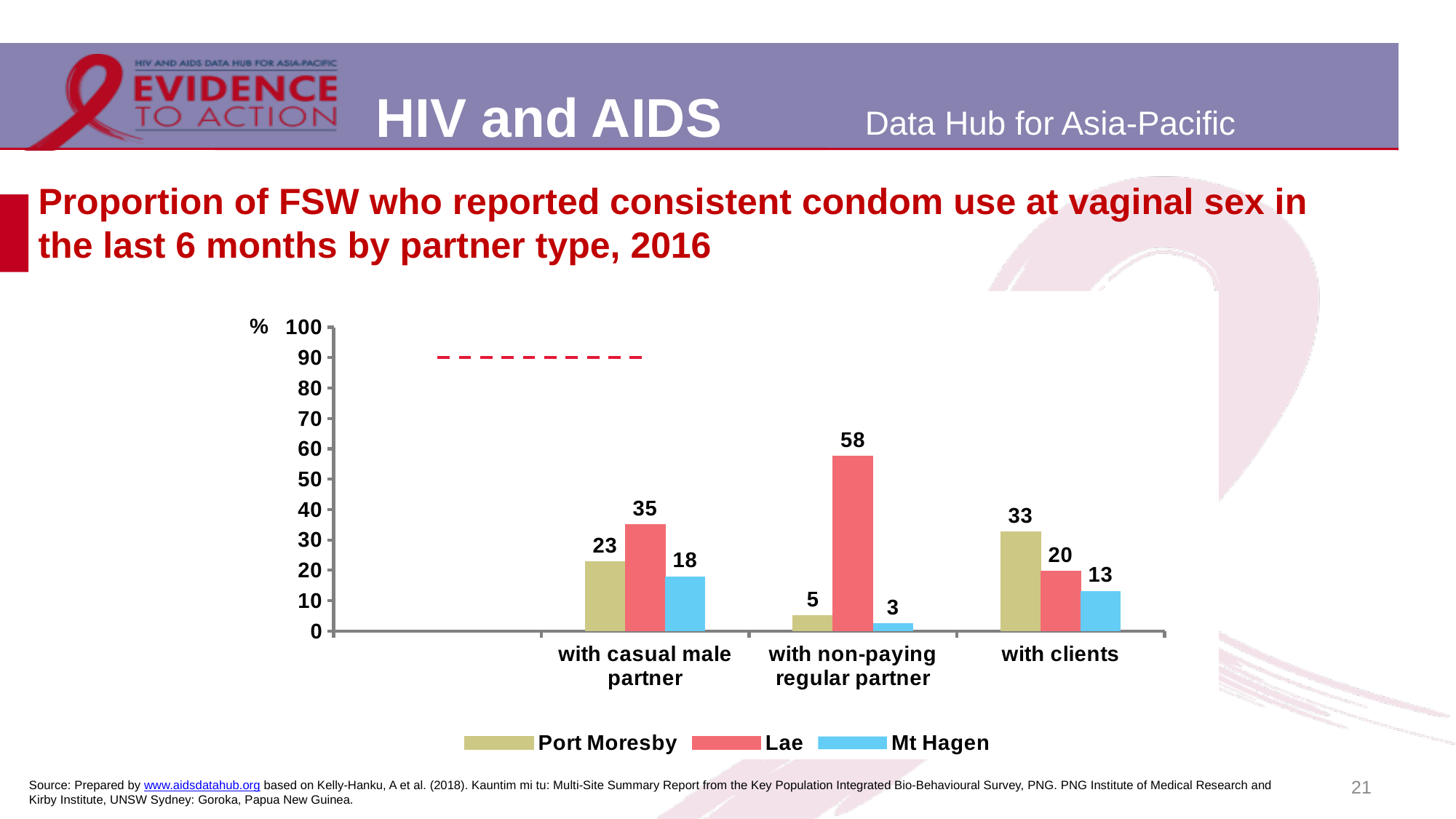
Which city has the lowest value for consistent condom use with clients? Mt Hagen What is the difference between the Lae and Port Moresby values with casual male partner? 12 Which is larger: the Port Moresby value with clients or the Lae value with clients? Port Moresby What is the value for Mt Hagen with casual male partner? 18 What is the value for Lae with non-paying regular partner? 58 How many series does the legend list? 3 Which city has the highest value for consistent condom use with non-paying regular partner? Lae How many partner type categories are shown on the x axis? 3 What is the value for Port Moresby with clients? 33 Is the value for Lae with non-paying regular partner greater or less than 50? greater Which series is shown in red in the legend? Lae What kind of chart is shown on the slide? bar chart